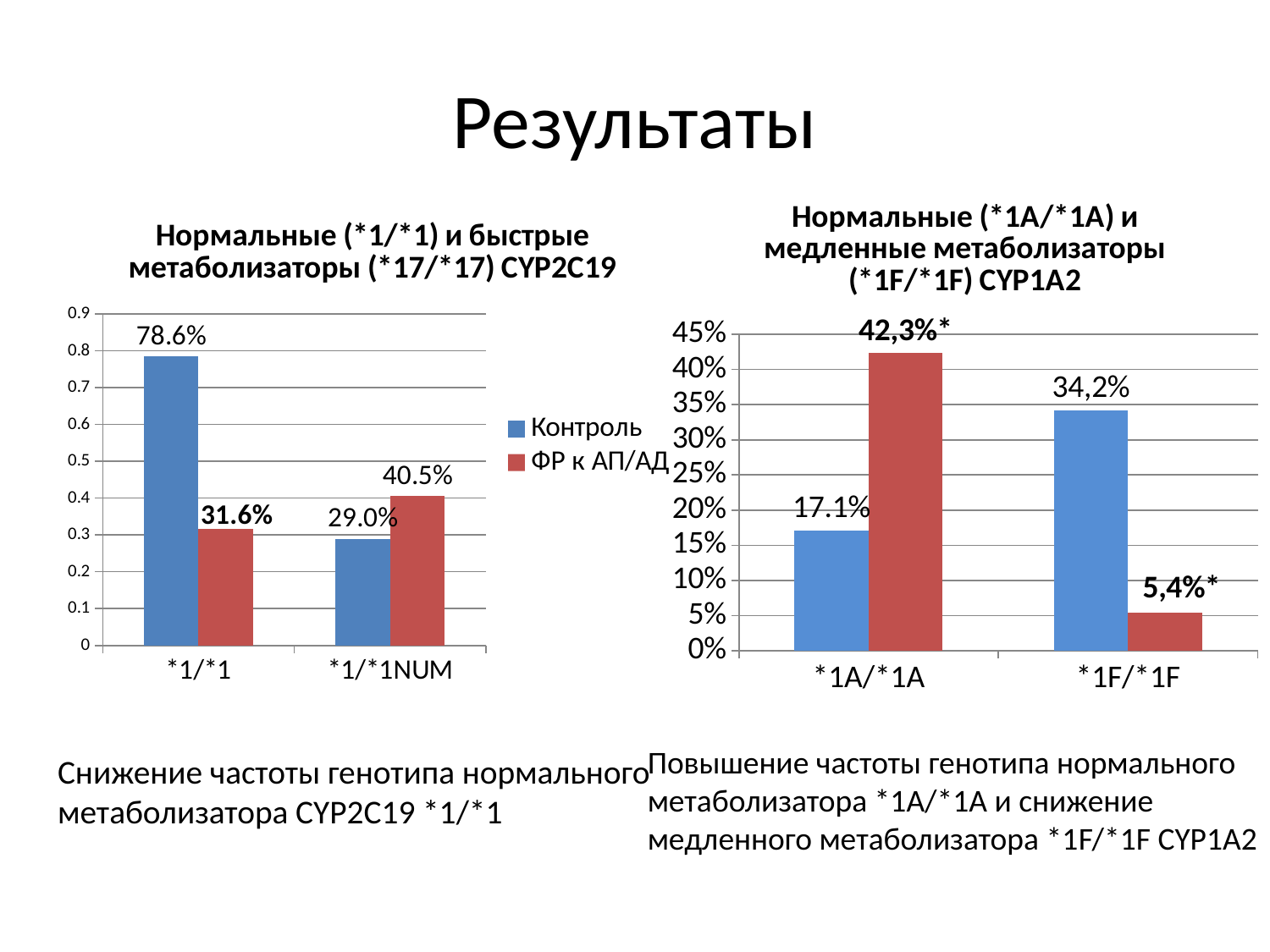
What type of chart is the left chart (CYP2C19)? bar chart In the left chart (CYP2C19), what is the difference between the Контроль and ФР к АП/АД values at *1/*1? 47.0% In the right chart (CYP1A2), which bar is the lowest? ФР к АП/АД at *1F/*1F In the left chart (CYP2C19), what is the value for ФР к АП/АД at *1/*1NUM? 40.5% In the left chart (CYP2C19), what is the value for ФР к АП/АД at *1/*1? 31.6% In the left chart (CYP2C19), what is the value for Контроль at *1/*1? 78.6% In the left chart (CYP2C19), which series has the larger value at *1/*1NUM? ФР к АП/АД In the right chart (CYP1A2), what is the value for Контроль at *1F/*1F? 34,2% How many series does the legend list? 2 In the right chart (CYP1A2), what is the value for ФР к АП/АД at *1A/*1A? 42,3%* In the right chart (CYP1A2), is the Контроль value at *1A/*1A greater or less than 20%? less In the right chart (CYP1A2), which bar is the highest? ФР к АП/АД at *1A/*1A